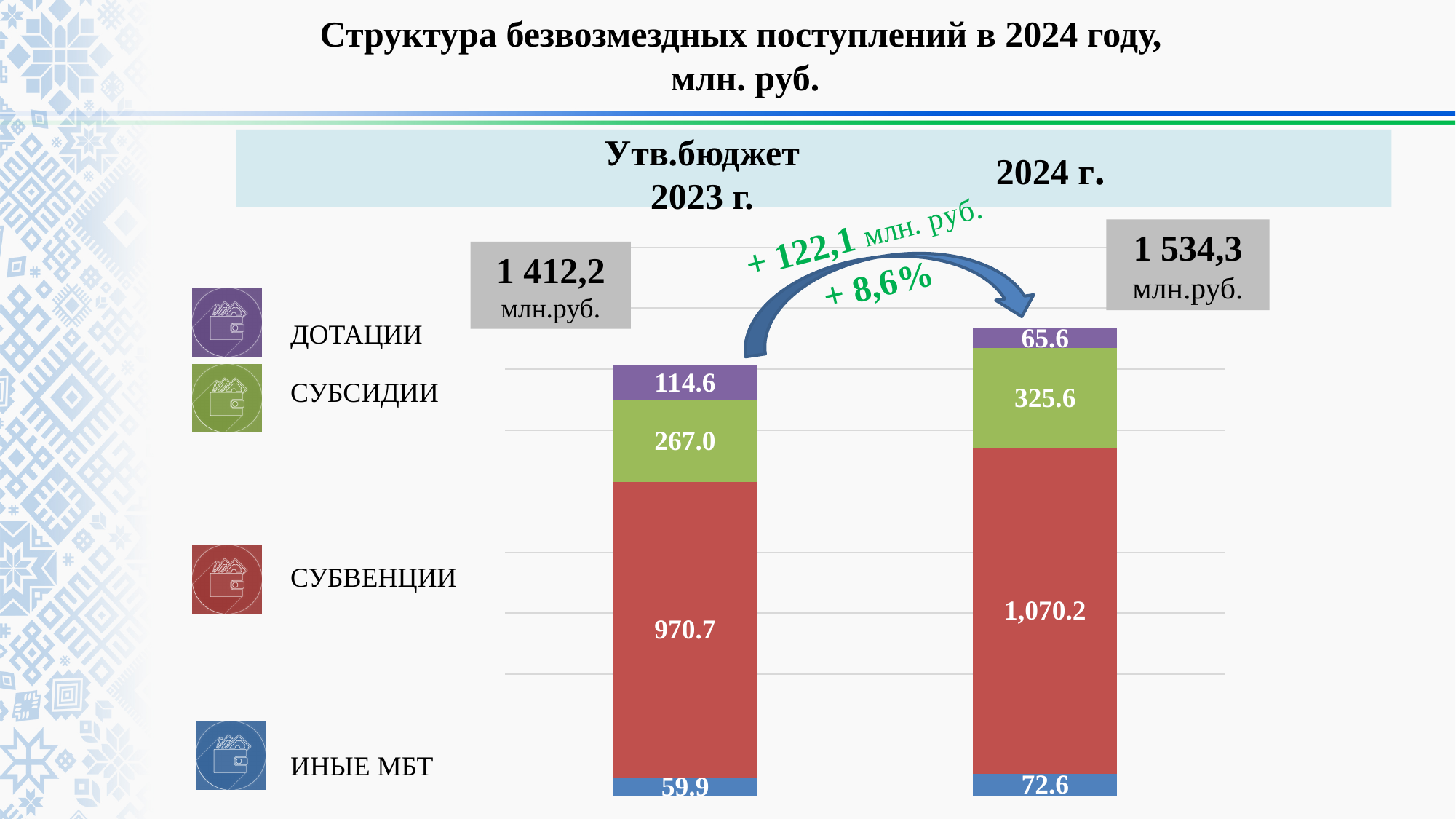
What is the difference between the СУБСИДИИ values for 2024 г. and Утв.бюджет 2023 г.? 58.6 Which series has the largest value in the 2024 г. bar? СУБВЕНЦИИ What is the total of the 2024 г. stacked bar as shown on the slide? 1 534,3 млн.руб. Which is larger: ДОТАЦИИ for Утв.бюджет 2023 г. or ДОТАЦИИ for 2024 г.? Утв.бюджет 2023 г. What is the value of СУБСИДИИ for 2024 г.? 325.6 What colour represents СУБВЕНЦИИ in the chart? Red Which series has the smallest value in the Утв.бюджет 2023 г. bar? ИНЫЕ МБТ What is the value of ДОТАЦИИ for 2024 г.? 65.6 What is the value of СУБВЕНЦИИ for Утв.бюджет 2023 г.? 970.7 How many series does the legend list? 4 What kind of chart is shown on the slide? Stacked bar chart What is the value of ИНЫЕ МБТ for Утв.бюджет 2023 г.? 59.9